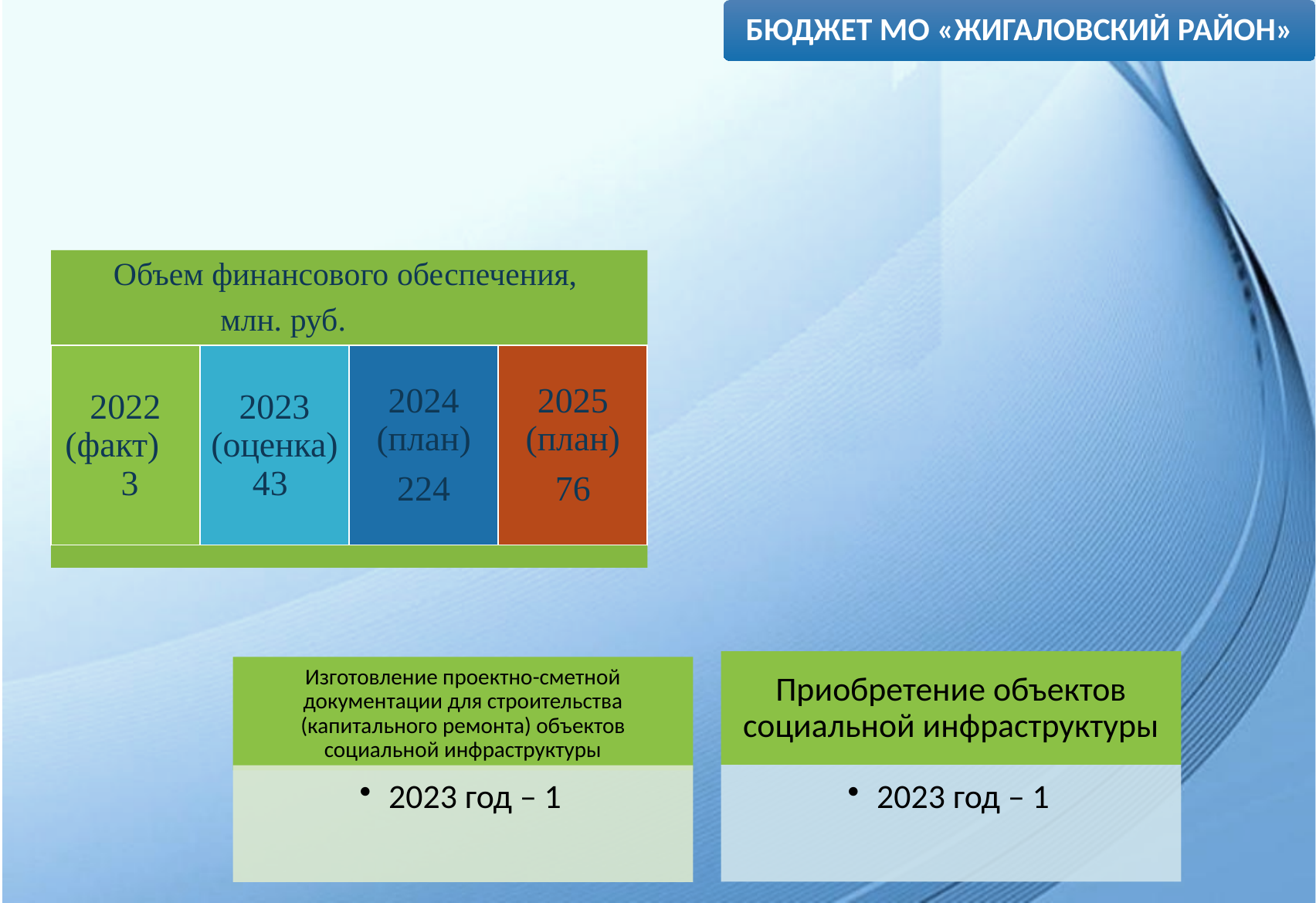
What is the difference between the 2023 (оценка) and 2022 (факт) values in the 'Объем финансового обеспечения, млн. руб.' graphic? 40 Which year has the lowest value in the 'Объем финансового обеспечения, млн. руб.' graphic? 2022 (факт) What is the value for 2025 (план) in the 'Объем финансового обеспечения, млн. руб.' graphic? 76 What is the value for 2024 (план) in the 'Объем финансового обеспечения, млн. руб.' graphic? 224 What is the value for 2023 (оценка) in the 'Объем финансового обеспечения, млн. руб.' graphic? 43 Which is larger in the 'Объем финансового обеспечения, млн. руб.' graphic: the value for 2023 (оценка) or for 2025 (план)? 2025 (план) What colour is the 2025 (план) block in the 'Объем финансового обеспечения, млн. руб.' graphic? Orange-red Which year has the highest value in the 'Объем финансового обеспечения, млн. руб.' graphic? 2024 (план) What unit is stated in the title of the 'Объем финансового обеспечения' graphic? млн. руб. How many years are shown in the 'Объем финансового обеспечения, млн. руб.' graphic? 4 What is the value for 2022 (факт) in the 'Объем финансового обеспечения, млн. руб.' graphic? 3 What is the difference between the 2024 (план) and 2025 (план) values in the 'Объем финансового обеспечения, млн. руб.' graphic? 148